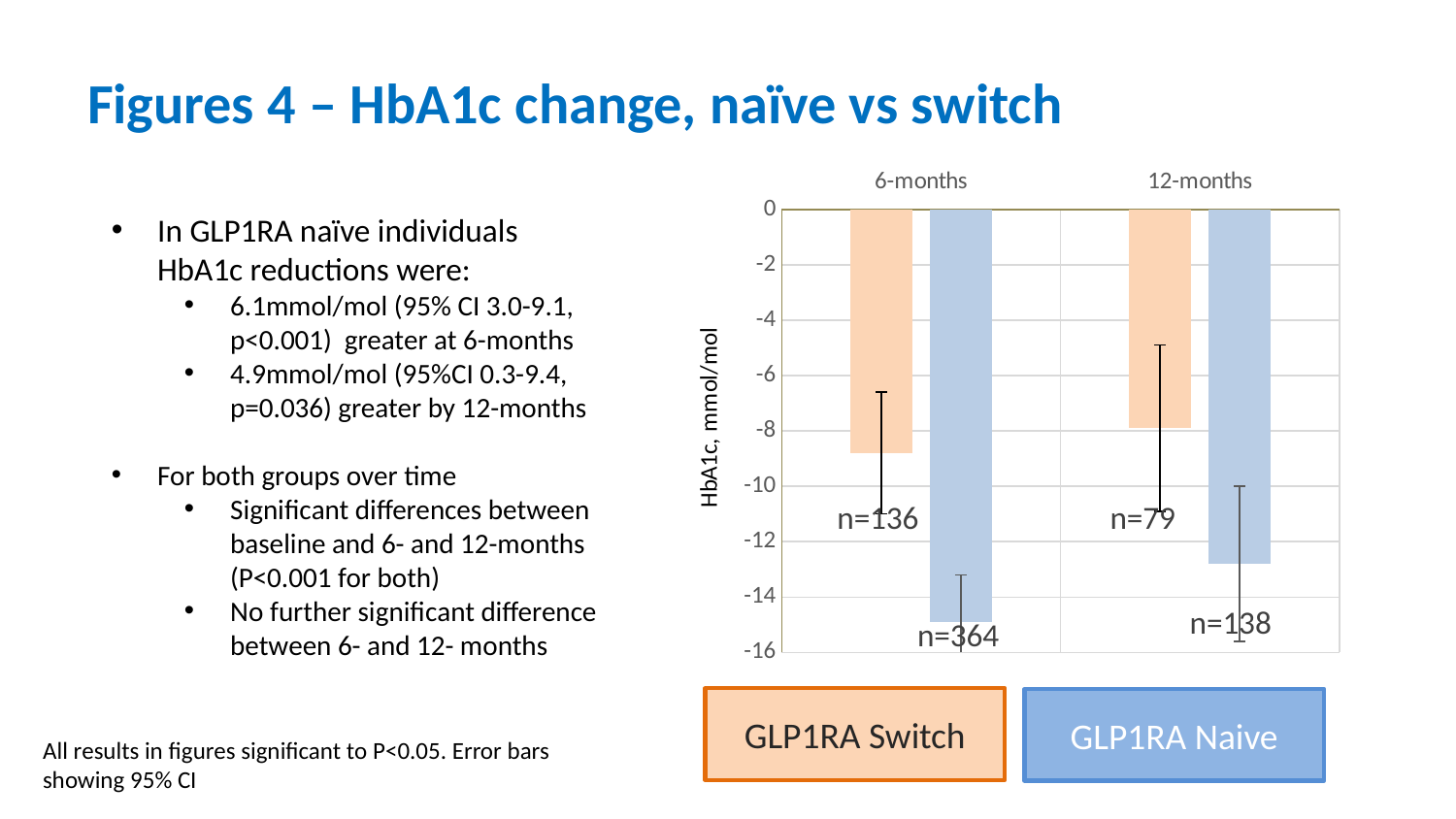
Is the HbA1c change for GLP1RA Naive at 6-months greater or less than -14? less Is the HbA1c change for GLP1RA Switch at 6-months greater or less than -8? less How many series does the chart's legend list? 2 What is the n value printed on the GLP1RA Switch bar at 12-months? n=79 What kind of chart is shown on the slide? bar chart How many time-point categories are shown on the x axis of the chart? 2 What is the n value printed on the GLP1RA Naive bar at 6-months? n=364 At 6-months, which group shows the larger HbA1c reduction, GLP1RA Switch or GLP1RA Naive? GLP1RA Naive What is the n value printed on the GLP1RA Naive bar at 12-months? n=138 What is the n value printed on the GLP1RA Switch bar at 6-months? n=136 Which bar shows the largest HbA1c reduction (the lowest value) on the chart? GLP1RA Naive at 6-months What is the label on the chart's vertical axis? HbA1c, mmol/mol